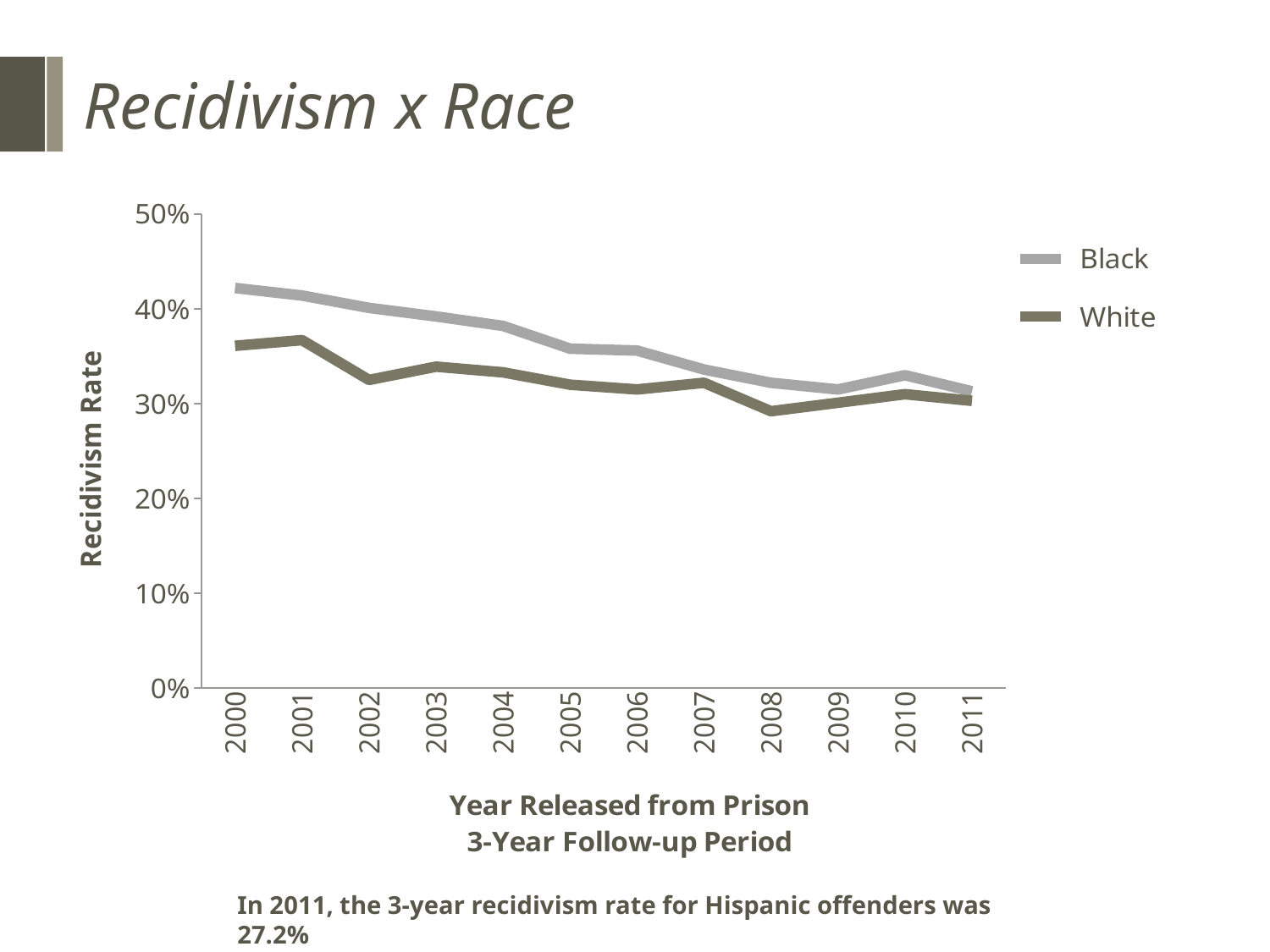
Does the recidivism rate for Black offenders generally rise or fall from 2000 to 2011? fall Is the recidivism rate for Black offenders released in 2005 greater or less than 30%? greater In 2004, which series has the higher recidivism rate, Black or White? Black Is the recidivism rate for White offenders released in 2000 greater or less than 40%? less What is the label of the y axis? Recidivism Rate In which year is the recidivism rate for Black offenders highest? 2000 What kind of chart is shown on the slide? line chart In which year is the recidivism rate for White offenders lowest? 2008 How many years are plotted along the x axis? 12 Is the recidivism rate for Black offenders released in 2000 greater or less than 40%? greater How many series does the legend list? 2